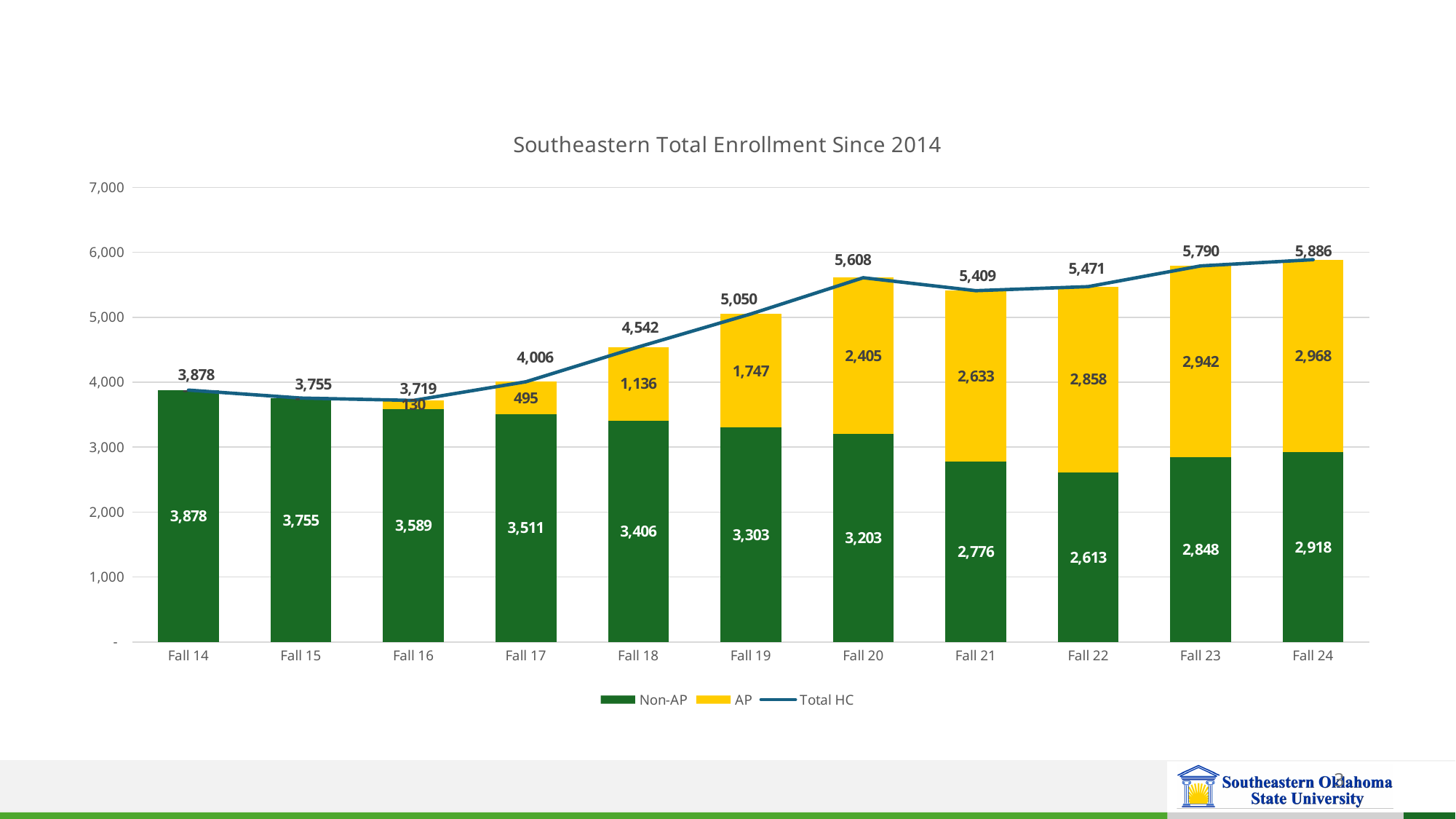
How many categories are shown on the x axis? 11 What is the total of the stacked bar for Fall 19? 5,050 How many series does the legend list? 3 Does the Non-AP value fall or rise from Fall 14 to Fall 22? Fall Which category has the highest Total HC value? Fall 24 What is the AP value for Fall 23? 2,942 What is the title of the chart? Southeastern Total Enrollment Since 2014 Which category has the lowest Non-AP value? Fall 22 What is the difference between the AP values for Fall 24 and Fall 17? 2,473 Which is larger, the Non-AP value for Fall 21 or the AP value for Fall 21? Non-AP (2,776) What is the Total HC value for Fall 18? 4,542 What is the Non-AP value for Fall 20? 3,203